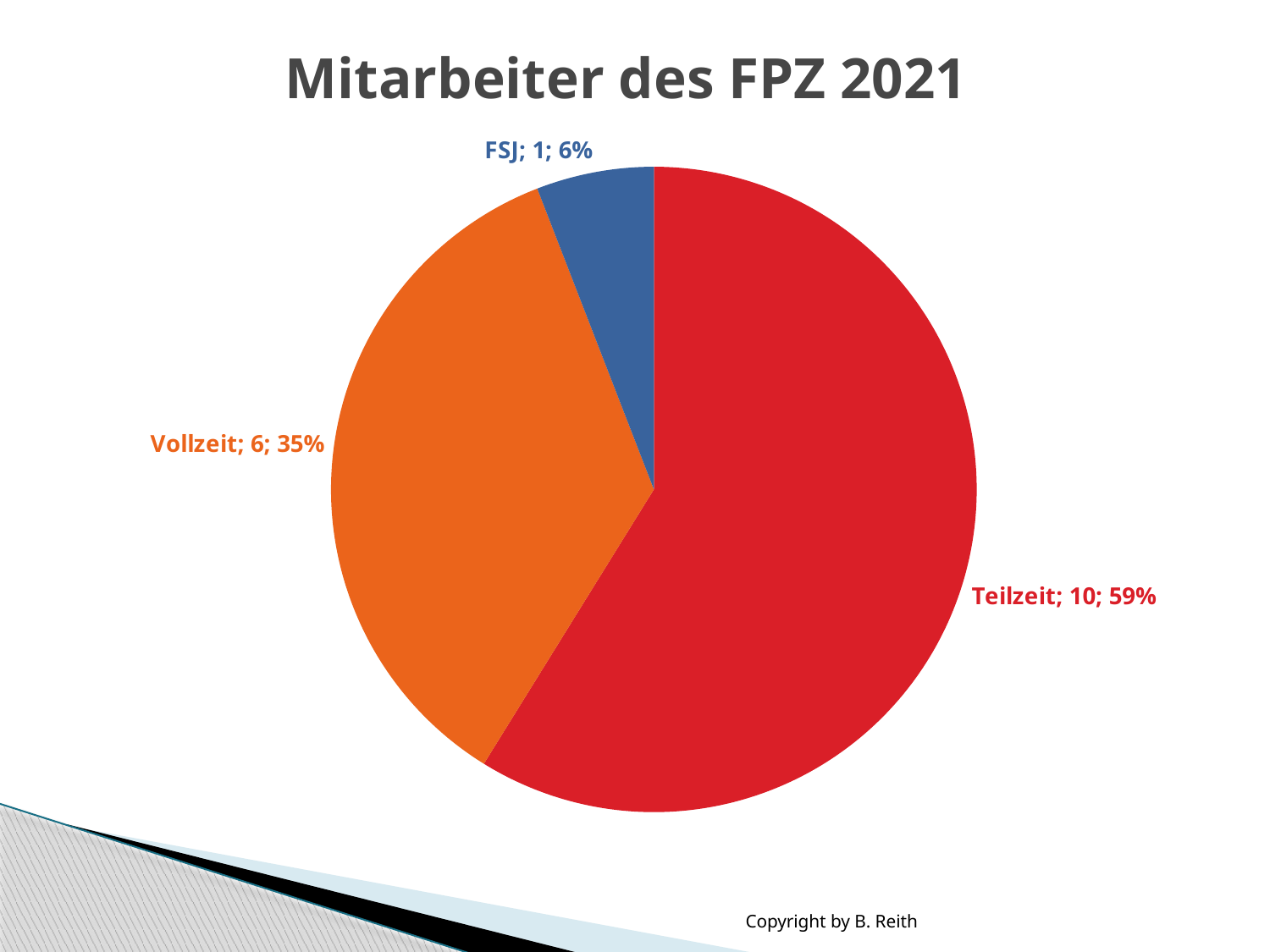
What is the value for Vollzeit? 6 What share of the pie does Teilzeit represent? 59% What is the value for Teilzeit? 10 What kind of chart is shown on the slide? pie chart Which category has the smallest slice? FSJ What share of the pie does FSJ represent? 6% What is the title of the chart? Mitarbeiter des FPZ 2021 What share of the pie does Vollzeit represent? 35% How many slices does the pie chart have? 3 Which category has the largest slice? Teilzeit What is the value for FSJ? 1 What is the difference between the values for Teilzeit and Vollzeit? 4